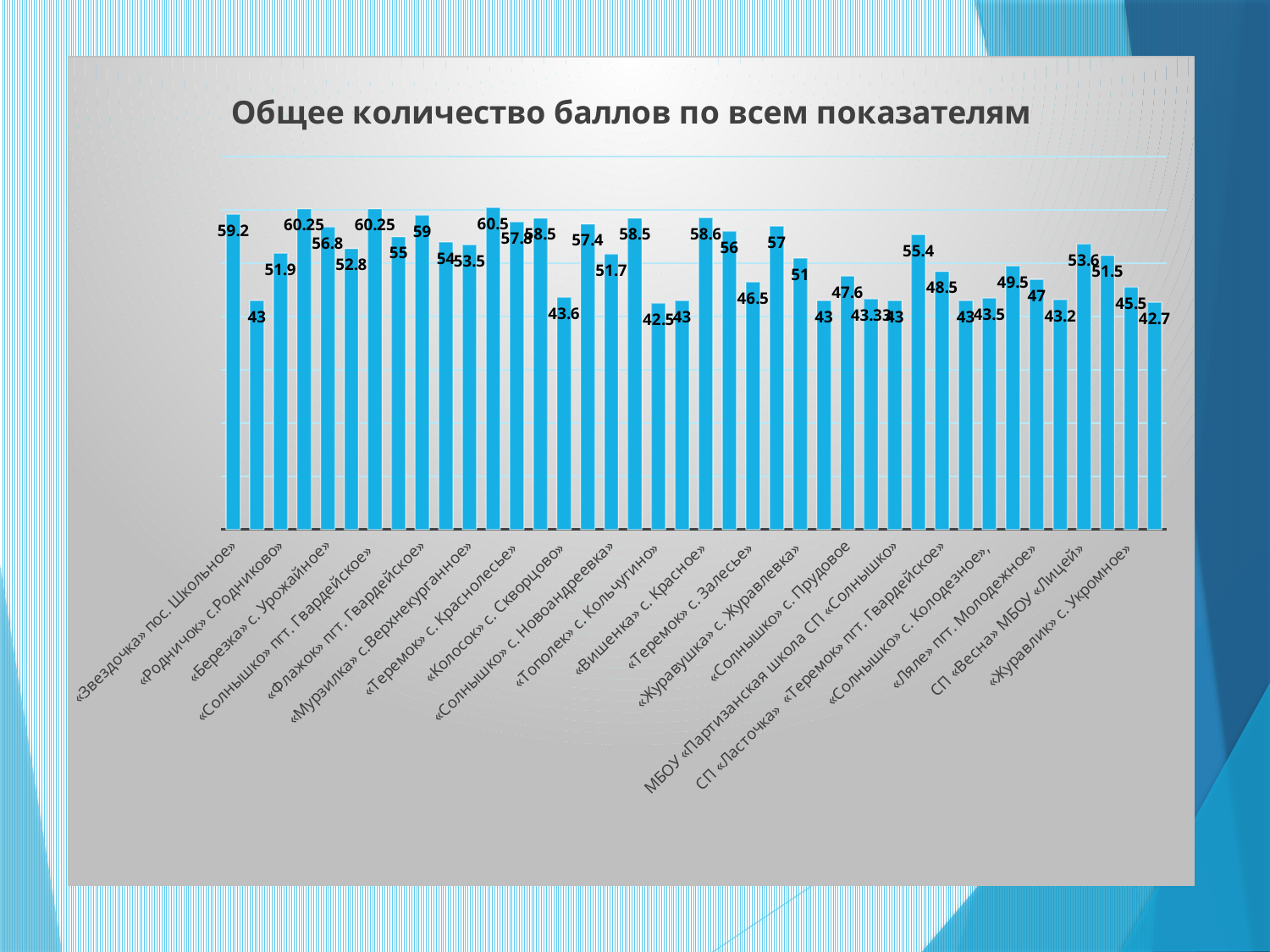
What colour are the bars on the chart? blue What is the difference between the first bar (59.2) and the second bar (43)? 16.2 What is the title of the chart? Общее количество баллов по всем показателям What is the difference between the highest value (60.5) and the lowest value (42.5) on the chart? 18 What kind of chart is shown on the slide? bar chart How many bars on the chart have the value 60.25? 2 Which is larger: the first bar («Звездочка» пос. Школьное, 59.2) or the second bar (43)? «Звездочка» пос. Школьное What is the lowest value shown on the chart? 42.5 What is the value for «Звездочка» пос. Школьное? 59.2 What is the highest value shown on the chart? 60.5 Is the value for «Звездочка» пос. Школьное greater or less than 50? greater